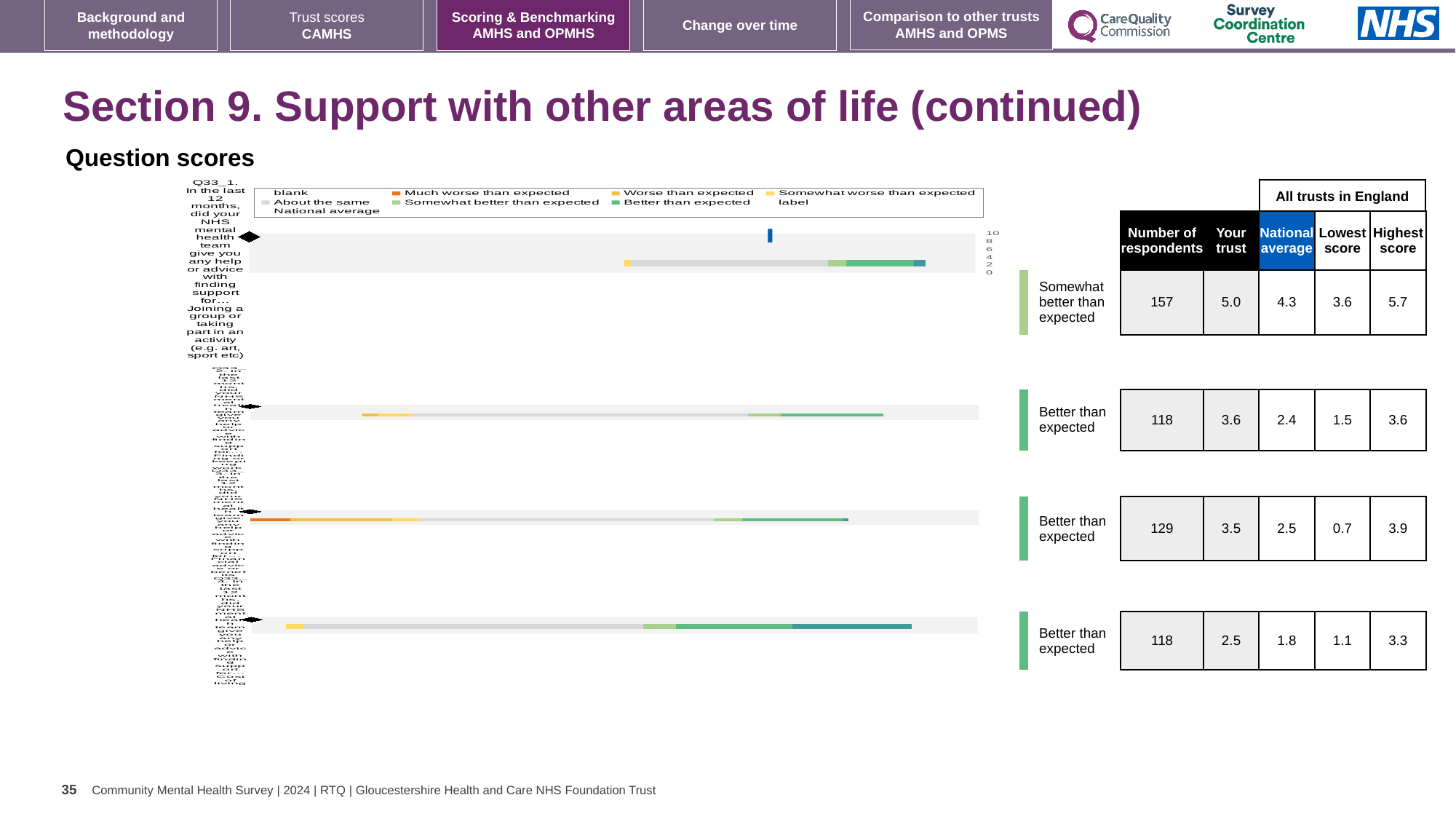
In the table beside the chart, what is the highest score across all trusts in England for the top row (Joining a group or taking part in an activity)? 5.7 How many horizontal bars are plotted in the question scores chart? 4 In the table beside the chart, how many respondents are listed for the top row (Joining a group or taking part in an activity)? 157 In the table beside the chart, what is the lowest 'Your trust' score among the four rows? 2.5 In the table beside the chart, what is the difference between 'Your trust' and the national average for the top row (Joining a group or taking part in an activity)? 0.7 What activity does the first (top) bar of the chart refer to, according to its category label? Joining a group or taking part in an activity (e.g. art, sport etc) How many of the four bars are rated 'Better than expected'? 3 In the table beside the chart, what is the national average for the top row (Joining a group or taking part in an activity)? 4.3 In the table beside the chart, what is the highest 'Your trust' score among the four rows? 5.0 What type of chart is shown under 'Question scores'? bar chart What benchmark rating is shown next to the top bar of the chart? Somewhat better than expected In the table beside the chart, what is the 'Your trust' score for the top row (Joining a group or taking part in an activity)? 5.0